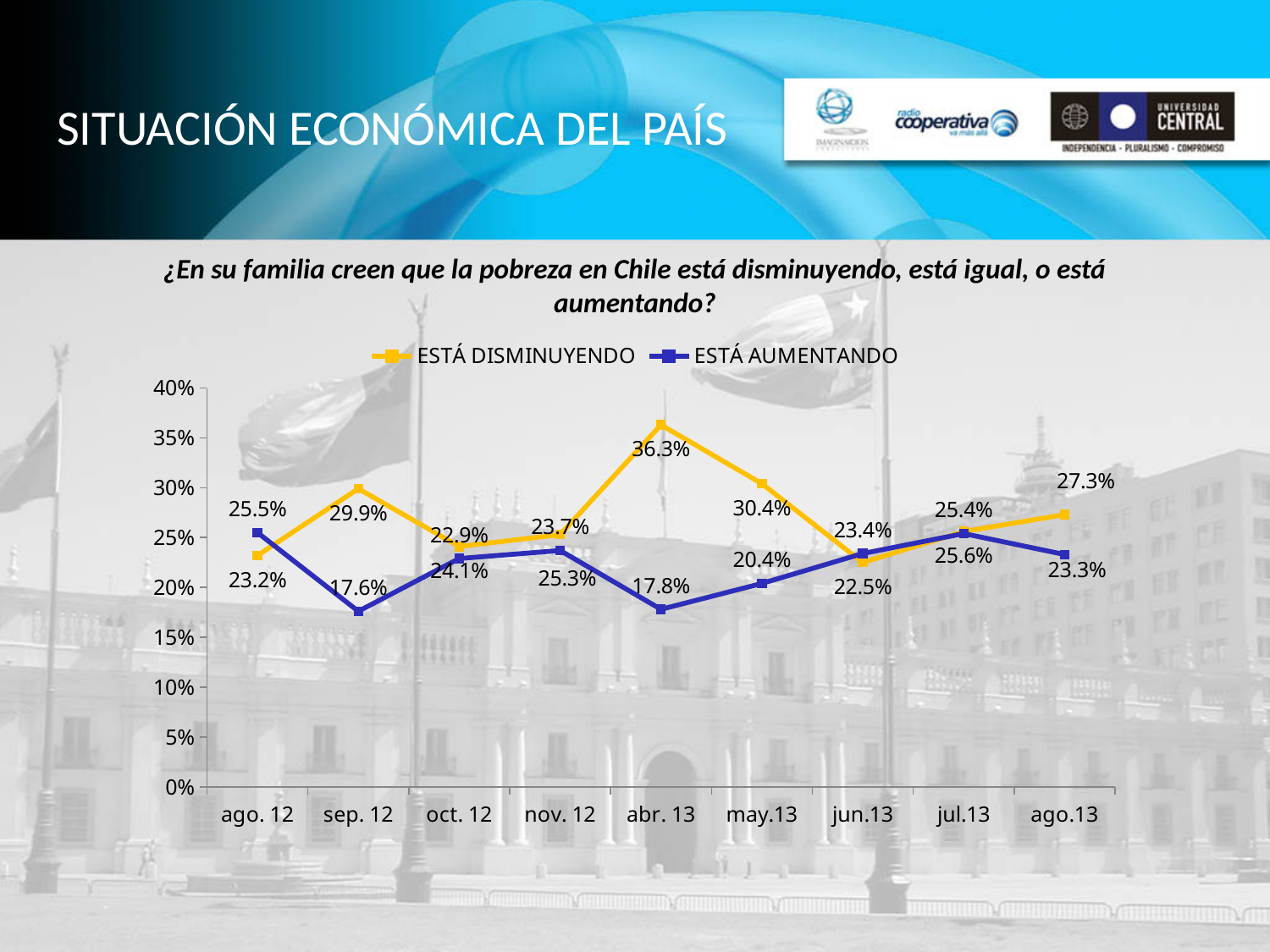
What is the difference between ESTÁ DISMINUYENDO and ESTÁ AUMENTANDO in abr. 13? 18.5 percentage points In which period does ESTÁ DISMINUYENDO reach its highest value? abr. 13 What type of chart is shown on the slide? line chart Is the value for ESTÁ DISMINUYENDO in abr. 13 greater or less than 35%? greater Which series has the larger value in sep. 12, ESTÁ DISMINUYENDO or ESTÁ AUMENTANDO? ESTÁ DISMINUYENDO How many series does the legend list? 2 What is the value for ESTÁ DISMINUYENDO in abr. 13? 36.3% What is the value for ESTÁ AUMENTANDO in ago.13? 23.3% How many time points are plotted along the x axis? 9 What is the value for ESTÁ AUMENTANDO in sep. 12? 17.6% Which colour is used for the ESTÁ AUMENTANDO series? blue What is the value for ESTÁ DISMINUYENDO in may.13? 30.4%